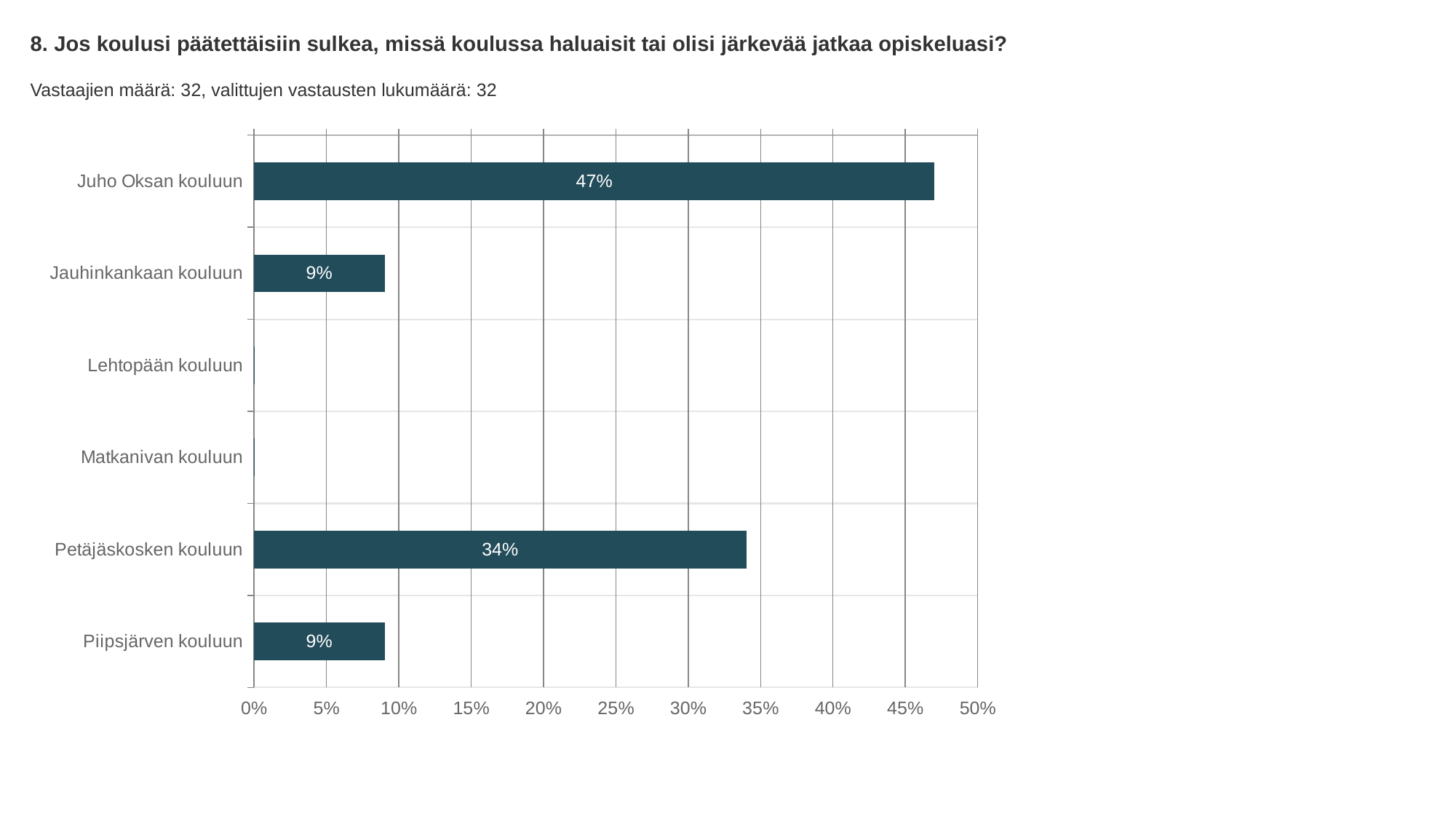
What is the value shown for Petäjäskosken kouluun? 34% Which school has the highest percentage? Juho Oksan kouluun Is the value for Juho Oksan kouluun greater or less than 40%? greater What is the value shown for Jauhinkankaan kouluun? 9% How many school categories are listed on the chart? 6 What percentage of respondents chose Juho Oksan kouluun? 47% Which two schools have no bar shown (no responses)? Lehtopään kouluun and Matkanivan kouluun What kind of chart is shown on the slide? bar chart What is the maximum value shown on the x axis? 50% Which is larger, the value for Petäjäskosken kouluun or the value for Piipsjärven kouluun? Petäjäskosken kouluun How many respondents are stated on the slide (Vastaajien määrä)? 32 What is the difference between the values for Juho Oksan kouluun and Petäjäskosken kouluun? 13%